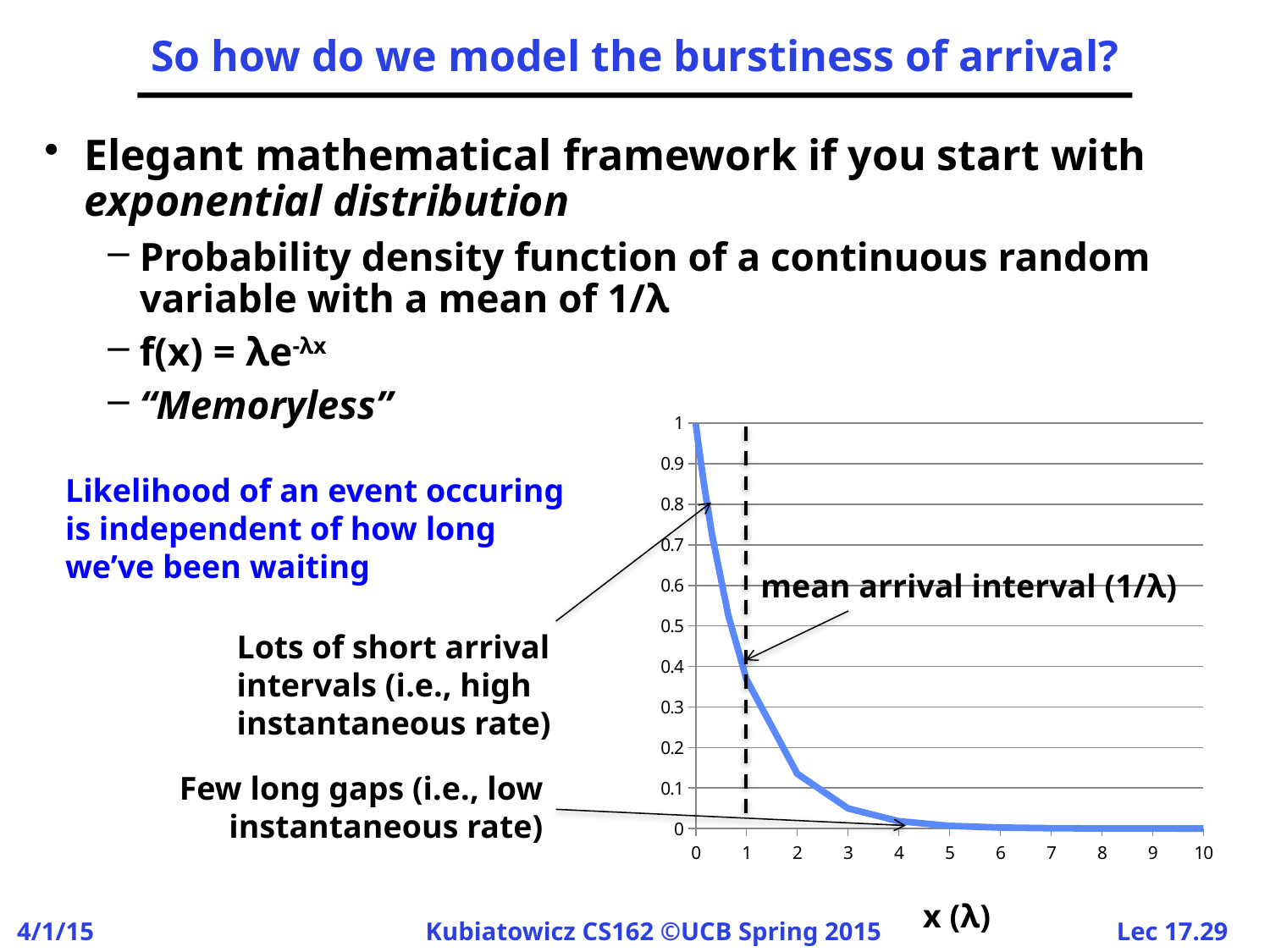
Which is larger, the value of the curve at x = 1 or at x = 3? x = 1 What is the highest value shown on the y axis of the chart? 1 Is the value of the curve at x = 4 greater or less than 0.1? less Is the value of the curve at x = 1 greater or less than 0.3? greater What does the vertical dashed line on the chart mark? mean arrival interval (1/λ) What kind of chart is shown on the slide? line chart What is the label of the x axis of the chart? x (λ) Is the value of the curve at x = 2 greater or less than 0.2? less Does the plotted curve rise or fall as x increases? fall At which x value does the curve reach its highest point? 0